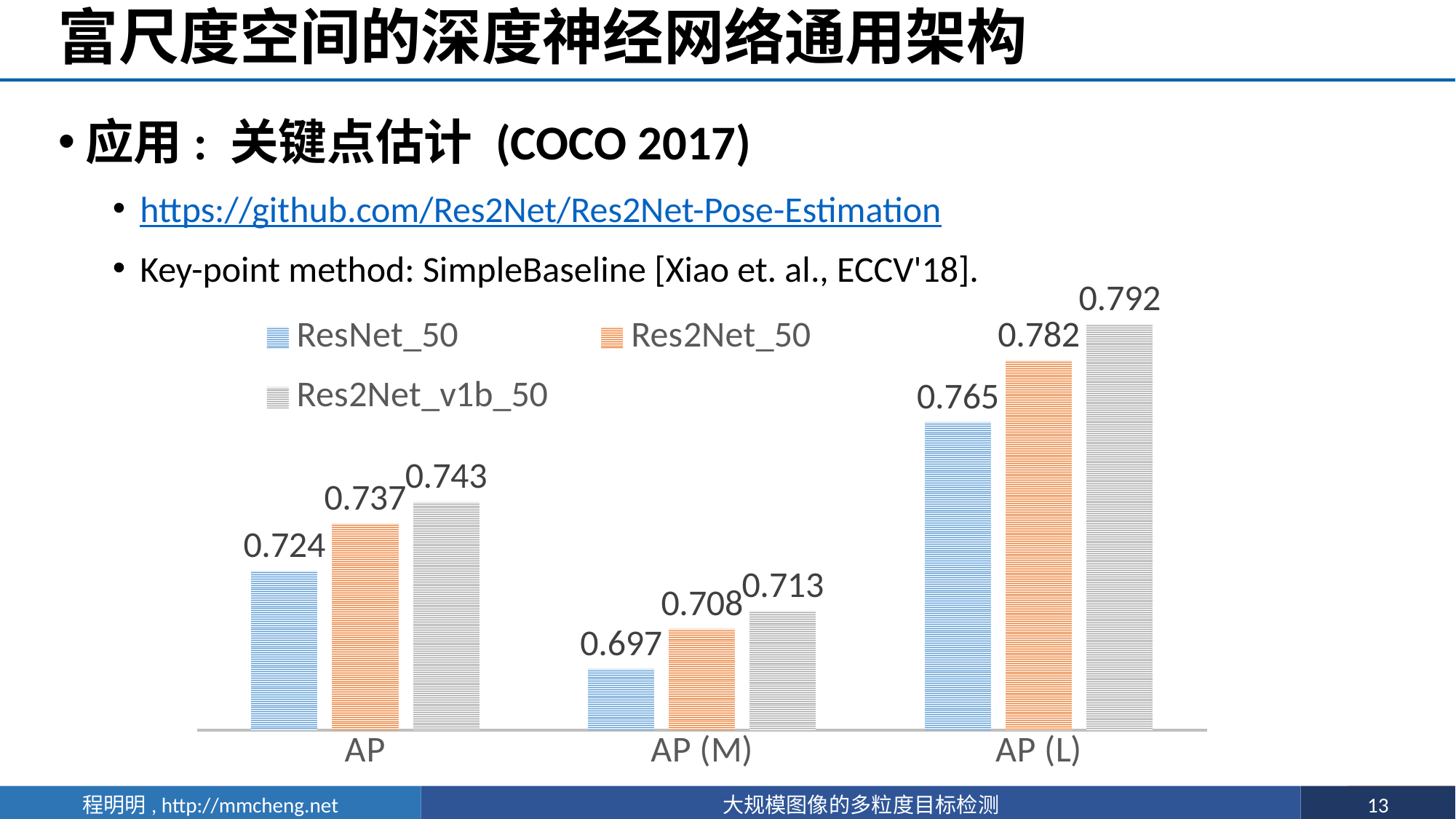
Which legend entry is shown in orange? Res2Net_50 What is the value for Res2Net_50 in the AP (M) category? 0.708 What is the difference between Res2Net_50 and ResNet_50 in the AP category? 0.013 Which is larger: Res2Net_50 in AP (L) or Res2Net_v1b_50 in AP? Res2Net_50 in AP (L) What is the difference between Res2Net_v1b_50 and ResNet_50 in the AP (L) category? 0.027 What is the value for ResNet_50 in the AP category? 0.724 How many categories are shown on the x axis? 3 How many series does the legend list? 3 Which series has the highest value in the AP (L) category? Res2Net_v1b_50 What kind of chart is shown on the slide? bar chart What is the value for Res2Net_v1b_50 in the AP (L) category? 0.792 Which category has the lowest value for ResNet_50? AP (M)